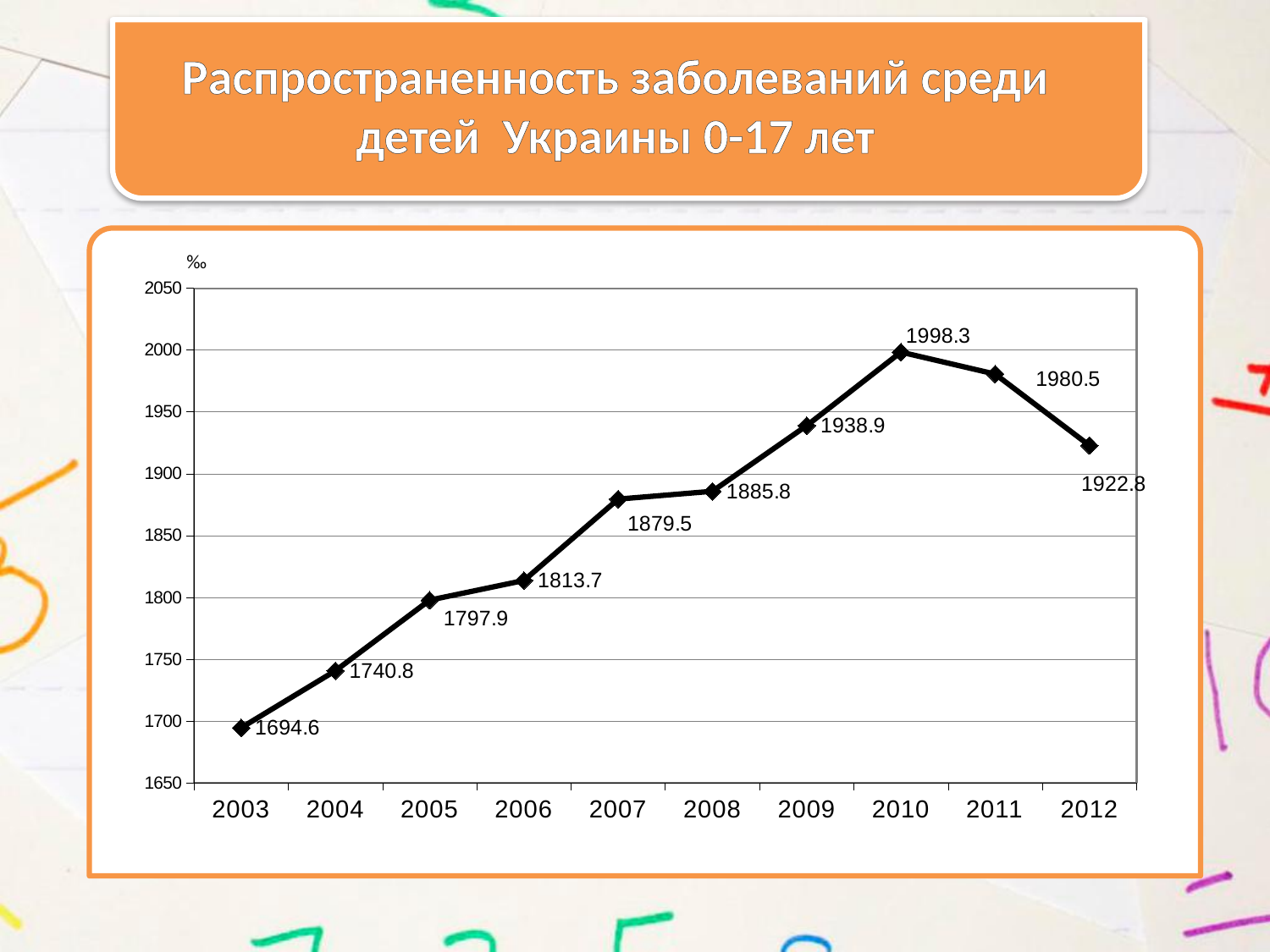
What is the difference between the values for 2011 and 2012? 57.7 Which year has the highest value? 2010 Which is larger, the value for 2009 or the value for 2012? 2009 Is the value for 2008 greater or less than 1900? less What is the value for 2010? 1998.3 What is the value for 2007? 1879.5 What is the difference between the values for 2010 and 2003? 303.7 What kind of chart is shown on the slide? line chart What is the value for 2003? 1694.6 What is the value for 2012? 1922.8 Which year has the lowest value? 2003 How many years are plotted on the chart? 10